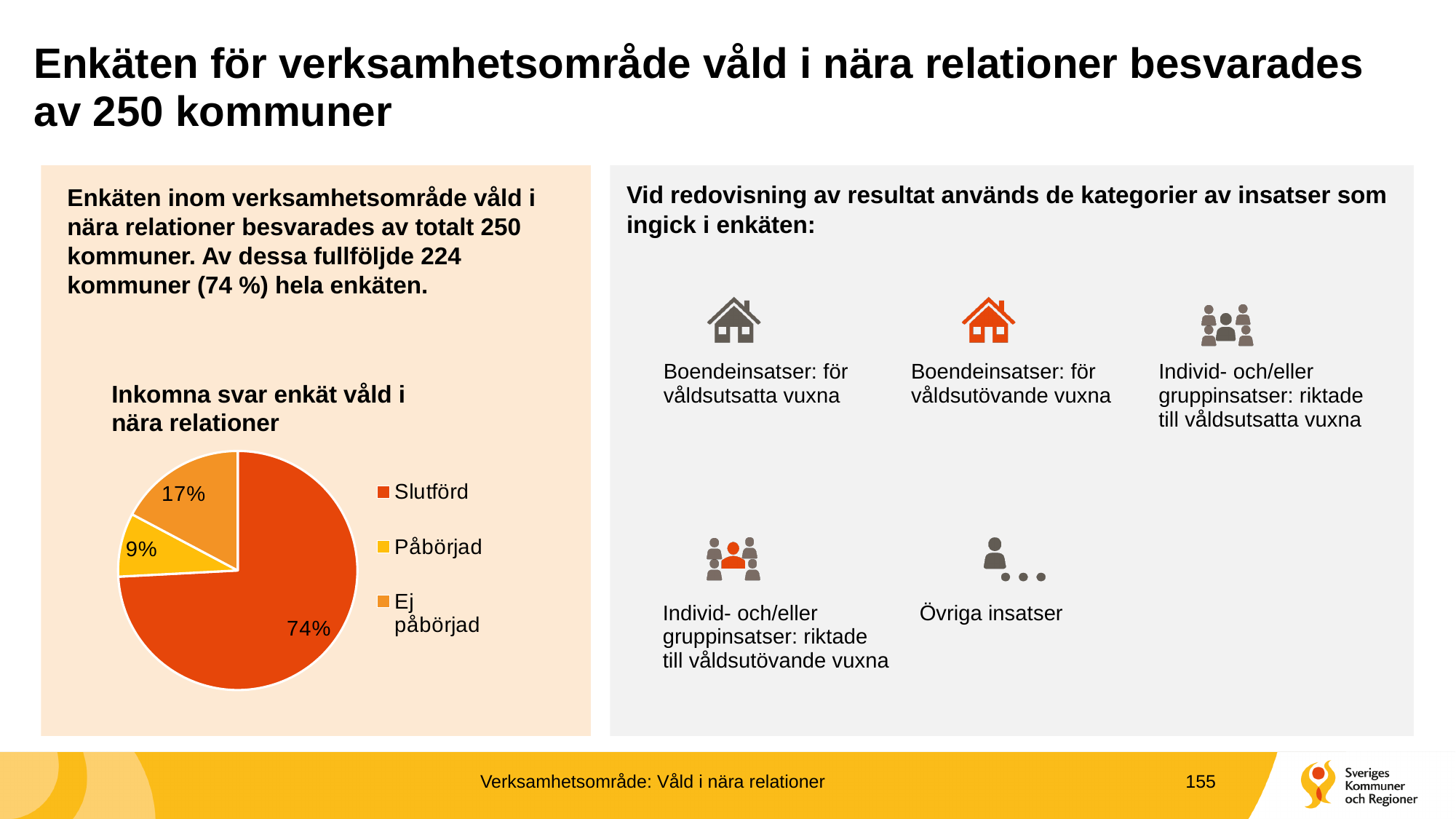
Which slice is larger, Påbörjad or Ej påbörjad? Ej påbörjad What kind of chart is shown on the slide? Pie chart How many entries does the legend list? 3 Which category has the largest slice of the pie? Slutförd Which category has the smallest slice of the pie? Påbörjad What share of the pie is labelled Ej påbörjad? 17% Which colour represents Påbörjad in the pie chart? Yellow What share of the pie is labelled Slutförd? 74% What is the title of the pie chart? Inkomna svar enkät våld i nära relationer What share of the pie is labelled Påbörjad? 9% What is the difference in percentage points between the Slutförd and Ej påbörjad slices? 57 How many slices does the pie chart have? 3